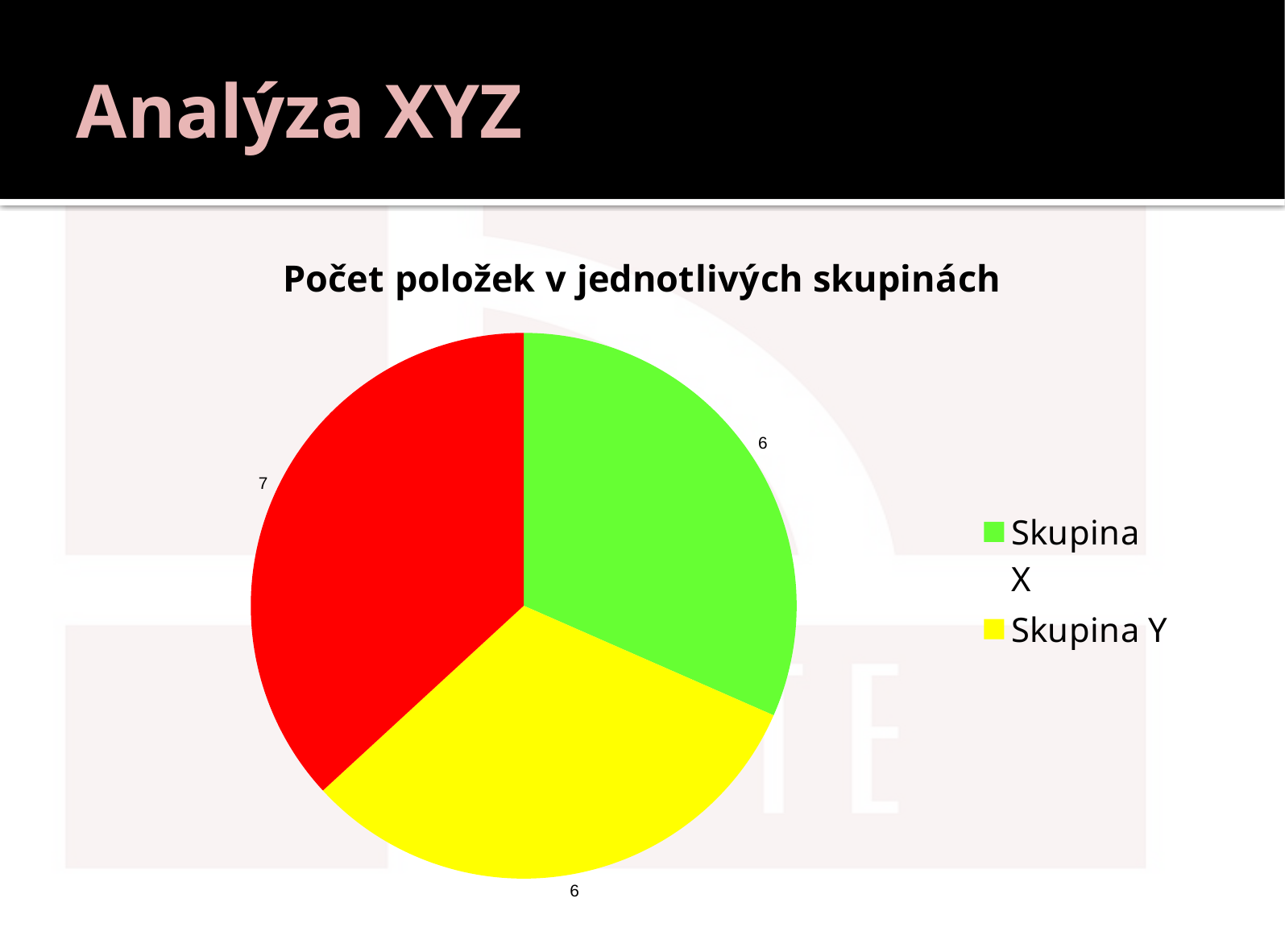
What value is shown for Skupina Y? 6 How many slices does the pie chart have? 3 What value is shown for Skupina X? 6 What kind of chart is shown on the slide? pie chart Which slice of the pie is the largest? the red slice What value is shown for the red slice of the pie? 7 What is the total of all the values shown on the pie chart? 19 What colour represents Skupina Y in the chart? yellow What is the difference between the red slice's value and the value for Skupina X? 1 How many entries are readable in the chart's legend? 2 What is the title of the chart? Počet položek v jednotlivých skupinách Are the values for Skupina X and Skupina Y equal? Yes